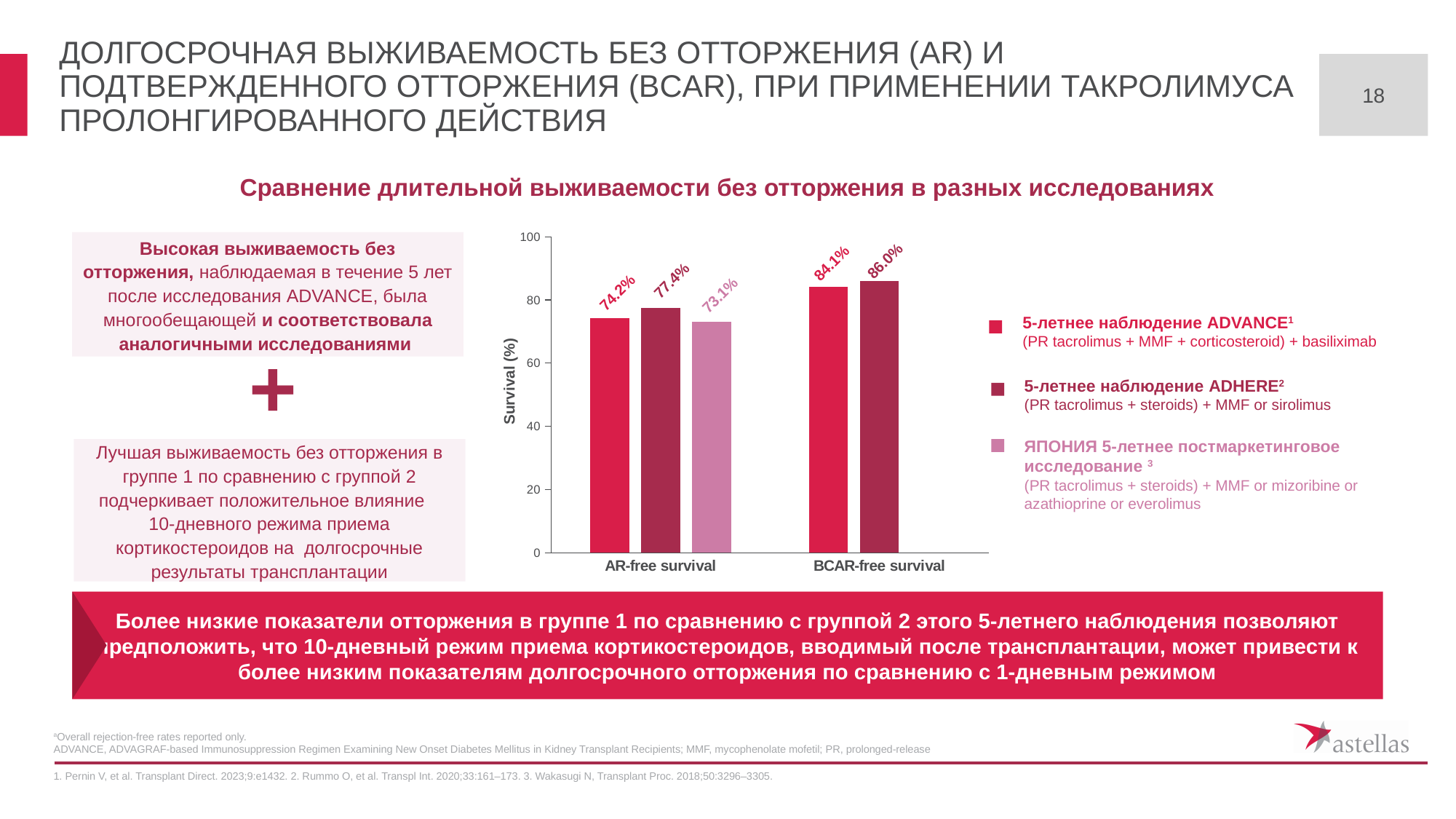
Is the BCAR-free survival value for the ADVANCE series greater or less than 80? greater How many series does the legend list? 3 What is the BCAR-free survival value for the 5-летнее наблюдение ADHERE series? 86.0% What kind of chart is shown on the slide? Bar chart Which series has the lowest AR-free survival value? ЯПОНИЯ 5-летнее постмаркетинговое исследование What is the label of the y axis of the chart? Survival (%) Which is larger for the ADVANCE series: AR-free survival or BCAR-free survival? BCAR-free survival What is the AR-free survival value for the ЯПОНИЯ 5-летнее постмаркетинговое исследование series? 73.1% Which series has the highest AR-free survival value? 5-летнее наблюдение ADHERE What is the AR-free survival value for the 5-летнее наблюдение ADVANCE series? 74.2% What is the difference between the BCAR-free survival values of the ADHERE and ADVANCE series? 1.9% What is the AR-free survival value for the 5-летнее наблюдение ADHERE series? 77.4%